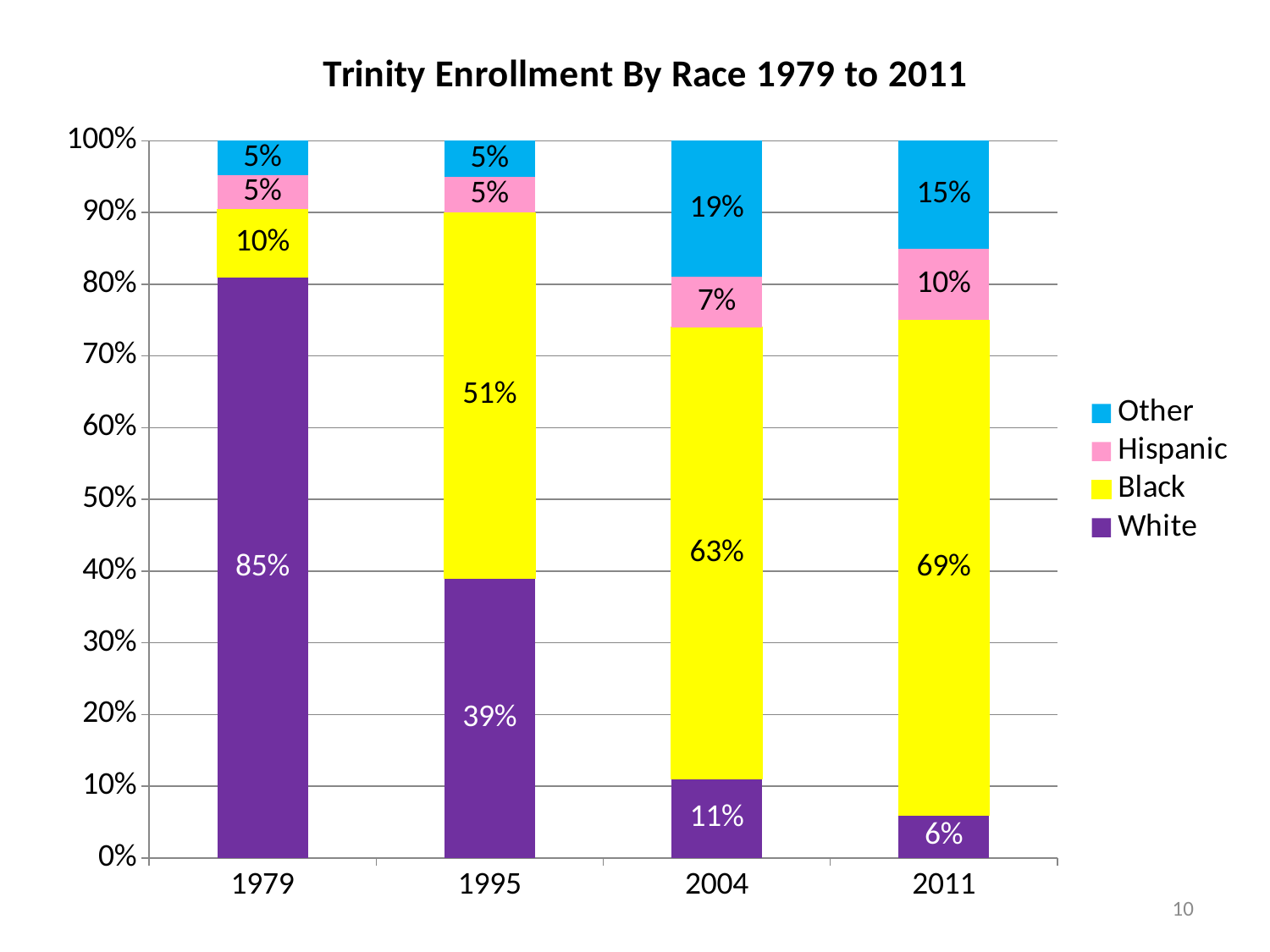
What is the White share of enrollment in 1979? 85% What is the Hispanic share of enrollment in 1995? 5% In which year is the White share of enrollment lowest? 2011 What is the Other share of enrollment in 2004? 19% Does the White share of enrollment rise or fall from 1979 to 2011? Fall What type of chart is shown on the slide? Stacked bar chart How many years are shown on the x axis? 4 What is the Black share of enrollment in 2011? 69% In which year is the Black share of enrollment highest? 2011 What is the title of the chart? Trinity Enrollment By Race 1979 to 2011 How many series does the legend list? 4 What is the difference between the White share in 1979 and the White share in 1995? 46%